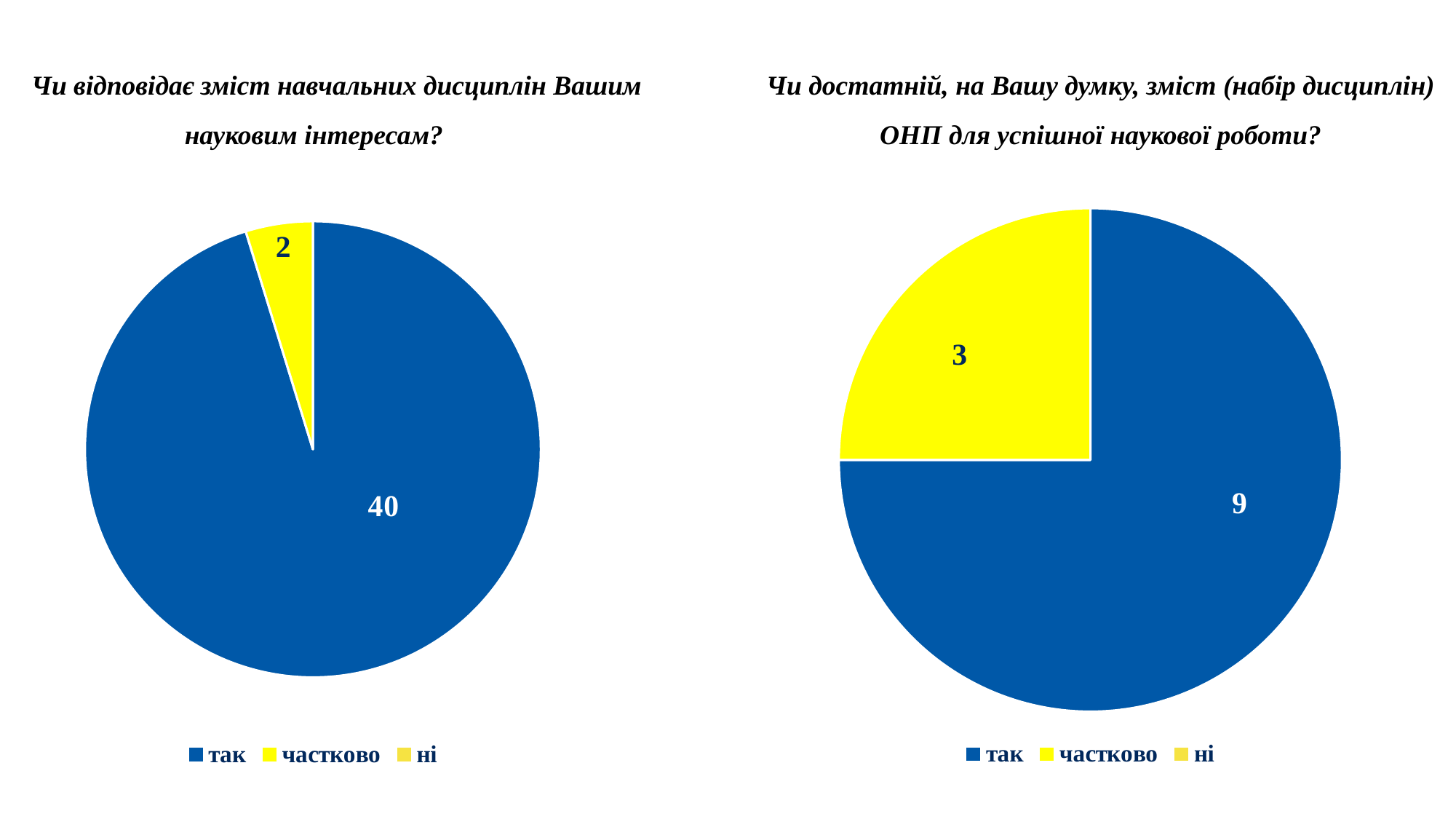
In the right pie chart, what is the value for "частково"? 3 In the right pie chart, which category has the largest slice? так In the right pie chart, which is larger: "так" or "частково"? так In the right pie chart, what colour is the slice for "частково"? Yellow In the left pie chart, what is the difference between the values for "так" and "частково"? 38 In the right pie chart, what is the difference between the values for "так" and "частково"? 6 In the left pie chart, what is the value for "частково"? 2 In the right pie chart ("Чи достатній, на Вашу думку, зміст (набір дисциплін) ОНП для успішної наукової роботи?"), what is the value for "так"? 9 In the left pie chart ("Чи відповідає зміст навчальних дисциплін Вашим науковим інтересам?"), what is the value for "так"? 40 What type of chart is shown on the right side of the slide? Pie chart How many entries does the legend of the left pie chart list? 3 In the left pie chart, which category has the largest slice? так